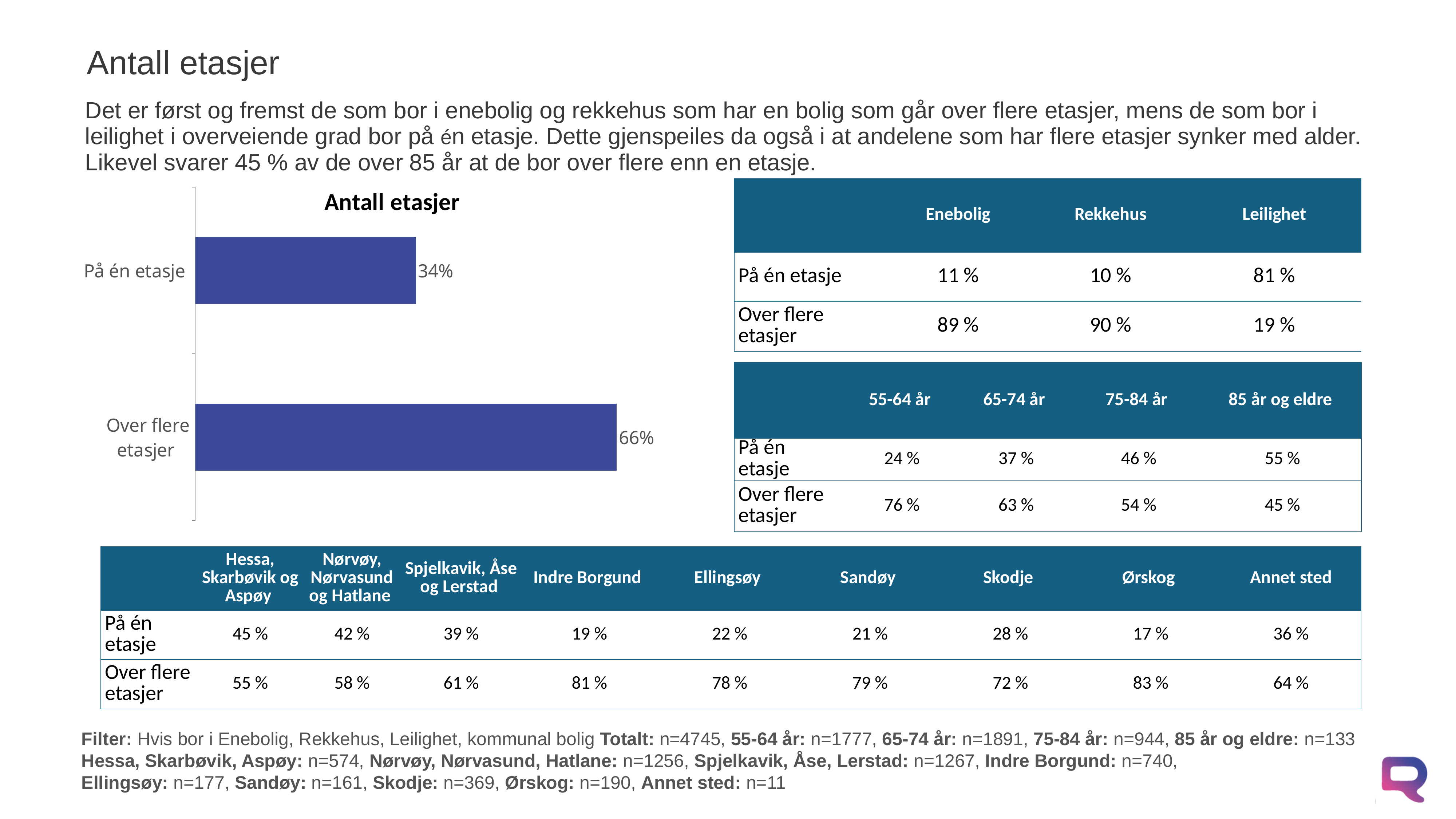
What kind of chart is shown on the slide? Bar chart What is the value for "Over flere etasjer" in the chart? 66% What is the difference between the values for "Over flere etasjer" and "På én etasje" in the chart? 32% Which category has the lowest value in the chart? På én etasje Which category has the highest value in the chart? Over flere etasjer What is the value for "På én etasje" in the chart? 34% What is the title of the chart? Antall etasjer Which is larger in the chart: "På én etasje" or "Over flere etasjer"? Over flere etasjer What is the total of the two values shown in the chart? 100% How many categories are shown in the chart? 2